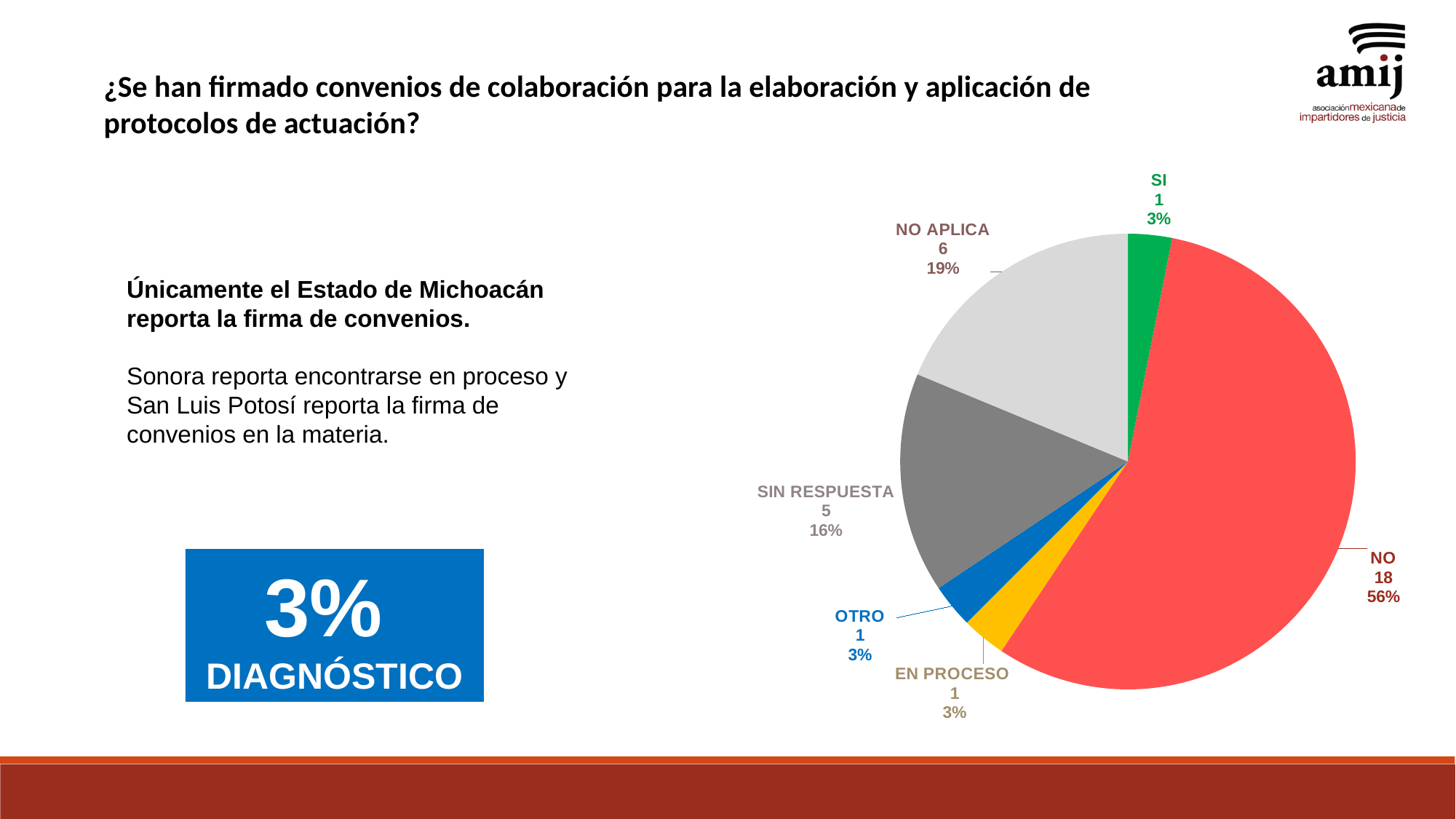
What is the count for the NO slice? 18 Which category has the largest slice? NO What is the count for EN PROCESO? 1 Which is larger, the count for SIN RESPUESTA or the count for NO APLICA? NO APLICA What is the total count across all slices of the pie chart? 32 What kind of chart is shown on the slide? pie chart What colour is the NO slice? red How many slices does the pie chart have? 6 What percentage share does the NO APLICA slice have? 19% What is the difference between the counts for NO and NO APLICA? 12 What is the count for SIN RESPUESTA? 5 What percentage share does the SI slice have? 3%